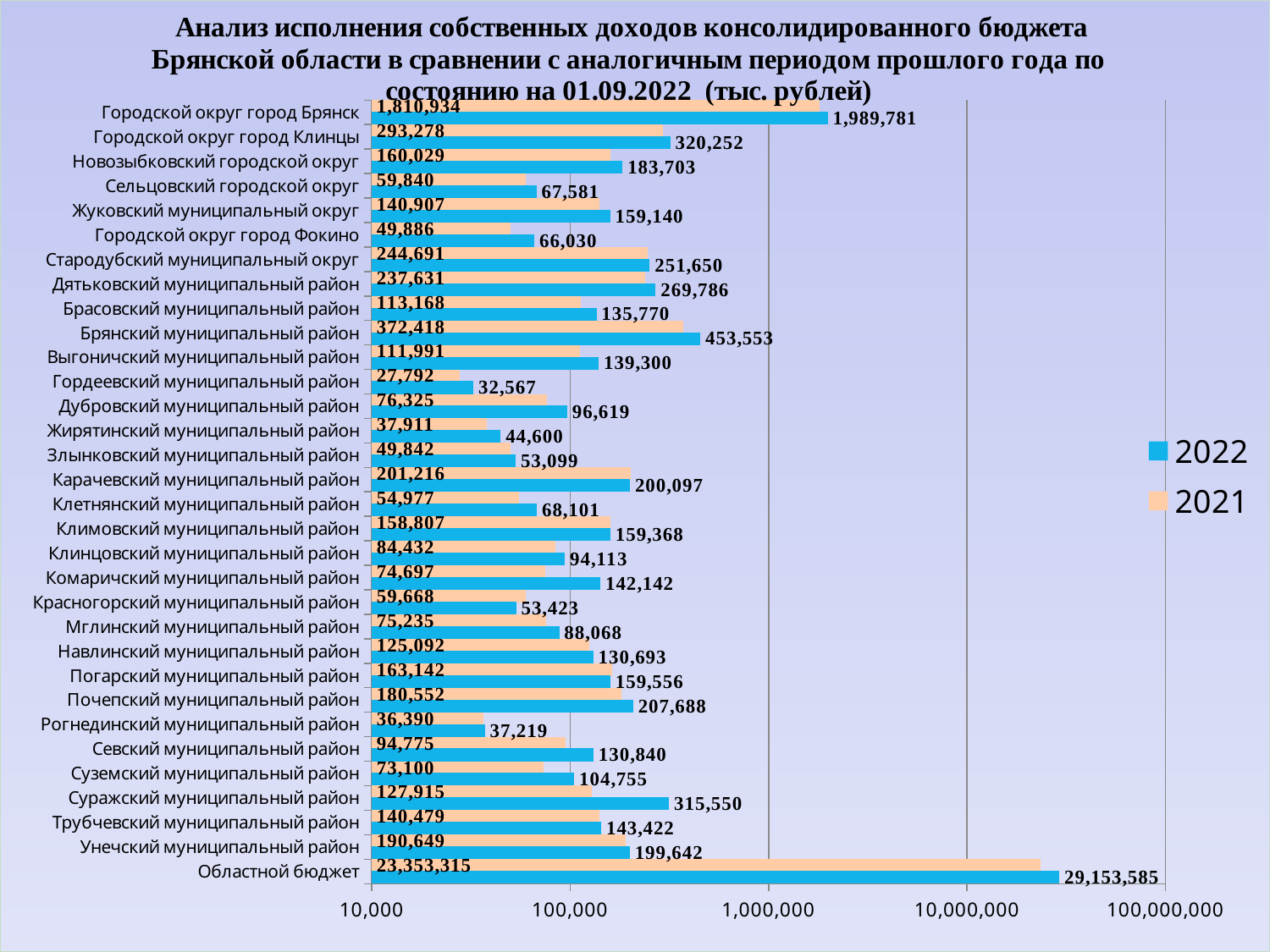
What is the 2022 value for Городской округ город Брянск? 1,989,781 For Карачевский муниципальный район, which year has the larger value, 2022 or 2021? 2021 What kind of chart is shown on the slide? bar chart Which category has the highest 2022 value? Областной бюджет Which colour represents the 2021 series in the legend? orange What is the difference between the 2022 and 2021 values for Брянский муниципальный район? 81,135 Which category has the lowest 2022 value? Гордеевский муниципальный район What is the 2022 value for Брянский муниципальный район? 453,553 How many categories are shown on the vertical axis? 32 How many series does the legend list? 2 What is the 2021 value for Областной бюджет? 23,353,315 What is the 2021 value for Гордеевский муниципальный район? 27,792